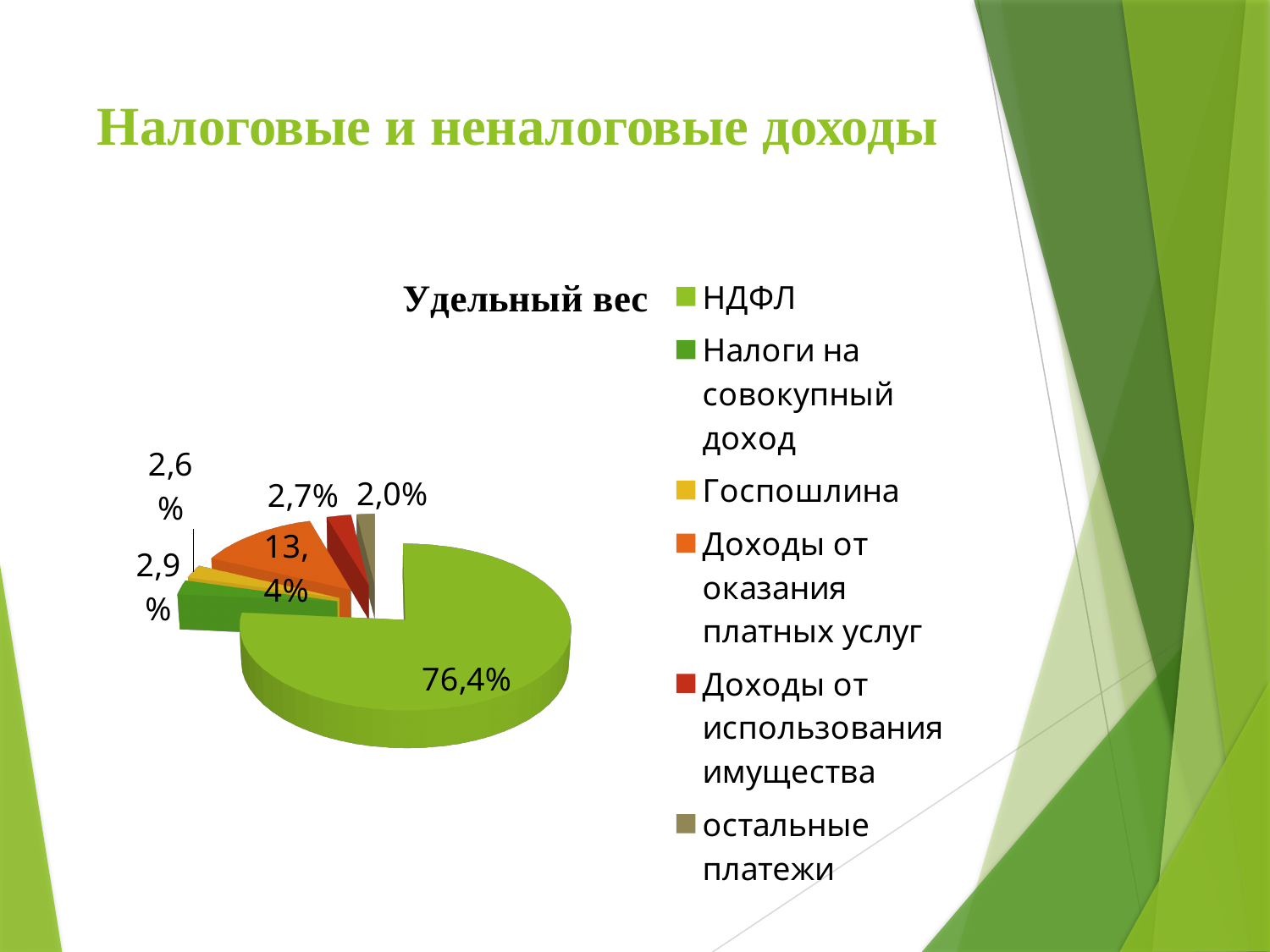
Which has a larger share: Налоги на совокупный доход or Доходы от использования имущества? Налоги на совокупный доход What share does Госпошлина have in the pie chart? 2,6% What share does НДФЛ have in the pie chart? 76,4% What is the title of the chart? Удельный вес What kind of chart is shown on the slide? pie chart What share does остальные платежи have in the pie chart? 2,0% How many entries does the legend list? 6 How many slices does the pie chart have? 6 Which category has the smallest share in the pie chart? остальные платежи Which category has the largest share in the pie chart? НДФЛ What is the difference between the shares of НДФЛ and Доходы от оказания платных услуг? 63,0% What share does Доходы от оказания платных услуг have in the pie chart? 13,4%